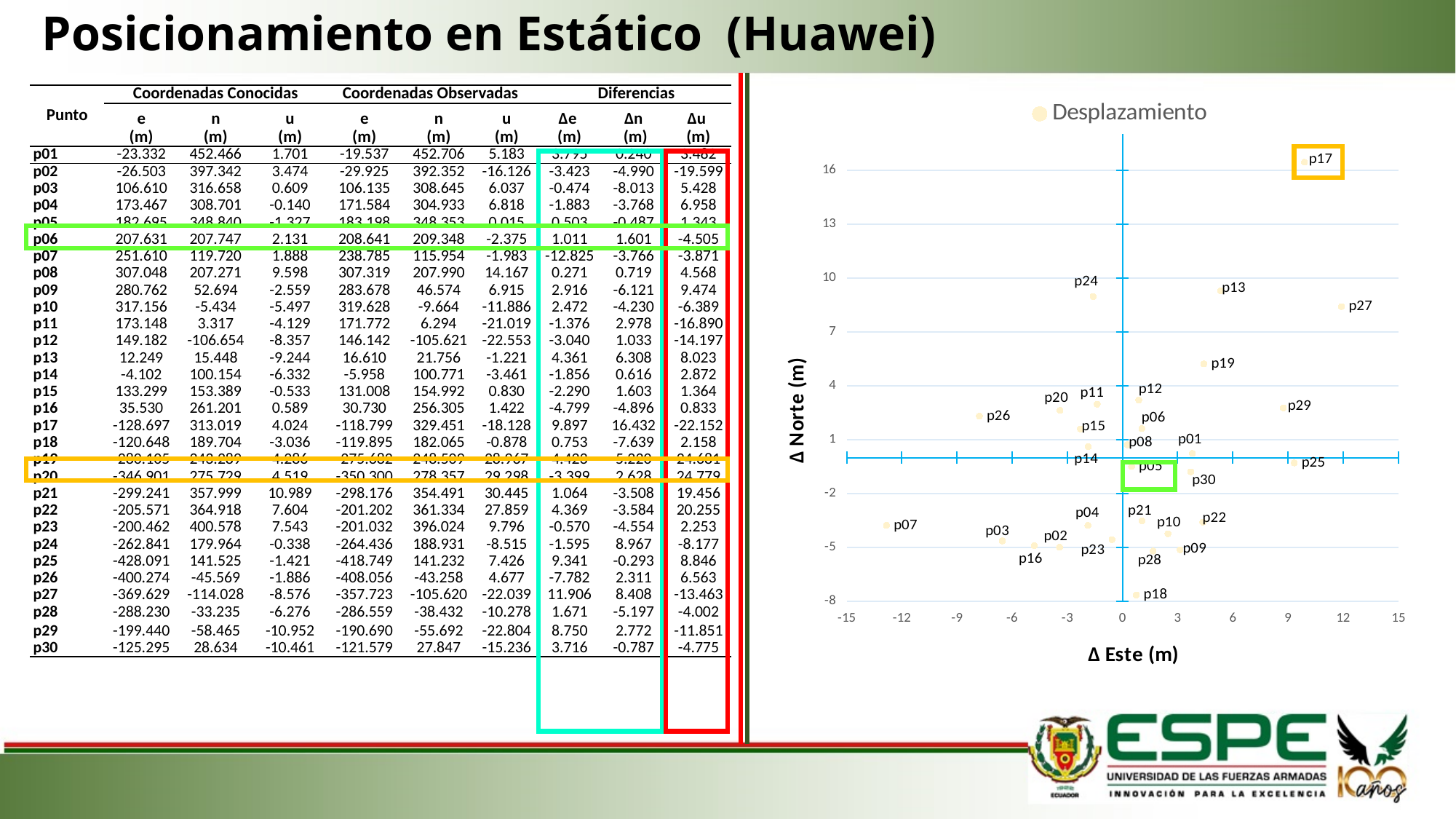
What is the legend entry of the chart? Desplazamiento Which point has the highest Δ Este value on the chart? p27 Which point has a larger Δ Este value, p27 or p07? p27 Which point has the lowest Δ Norte value on the chart? p18 What is the title of the horizontal axis of the chart? Δ Este (m) How many points are plotted on the chart? 30 Which point has the highest Δ Norte value on the chart? p17 Which point has the lowest Δ Este value on the chart? p07 Is the Δ Norte value for p17 greater or less than 13? greater Is the Δ Este value for p07 greater or less than -9? less What kind of chart is shown on the right side of the slide? scatter chart How many series does the legend of the chart list? 1